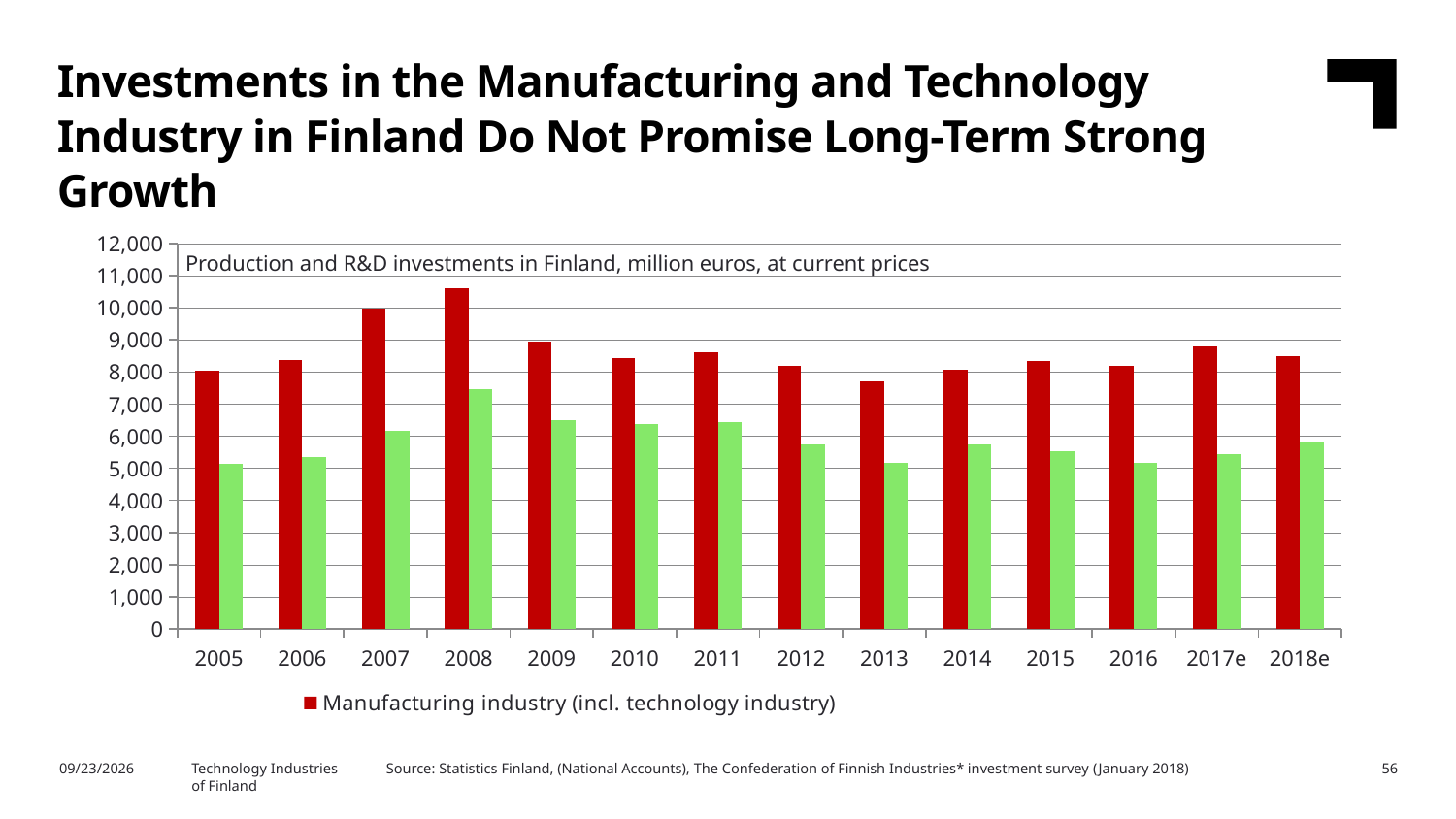
How many years are shown on the x axis of the chart? 14 Do the Manufacturing industry (incl. technology industry) values rise or fall from 2005 to 2008? Rise Is the green bar for 2012 greater or less than 6,000? less What kind of chart is shown on the slide? Bar chart In which year is the Manufacturing industry (incl. technology industry) bar the highest? 2008 Which year has the larger Manufacturing industry (incl. technology industry) value, 2007 or 2008? 2008 Is the green bar for 2008 greater or less than 7,000? greater How many series does the chart's legend list? 1 Is the Manufacturing industry (incl. technology industry) value for 2013 greater or less than 8,000? less What is the text shown inside the chart area describing the data? Production and R&D investments in Finland, million euros, at current prices In which year is the Manufacturing industry (incl. technology industry) bar the lowest? 2013